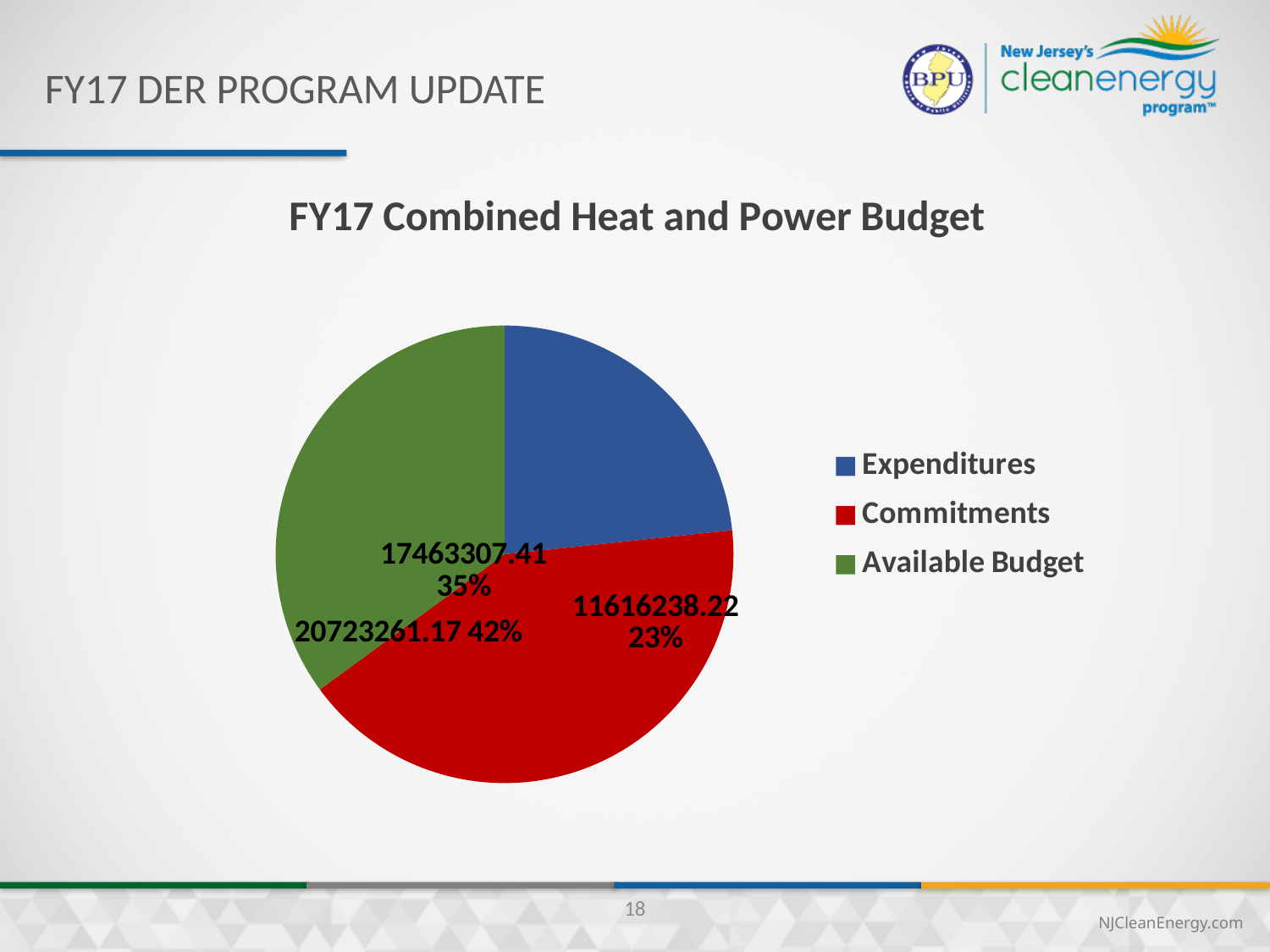
What kind of chart is shown on the slide? Pie chart Which category has the smallest slice? Expenditures What share of the pie does Commitments represent? 42% What share of the pie does Expenditures represent? 23% What is the difference between the Commitments value and the Expenditures value? 9107022.95 What value is shown for Expenditures? 11616238.22 What value is shown for Commitments? 20723261.17 How many categories does the legend list? 3 Which category has the largest slice? Commitments What share of the pie does Available Budget represent? 35% What value is shown for Available Budget? 17463307.41 What is the title of the chart? FY17 Combined Heat and Power Budget